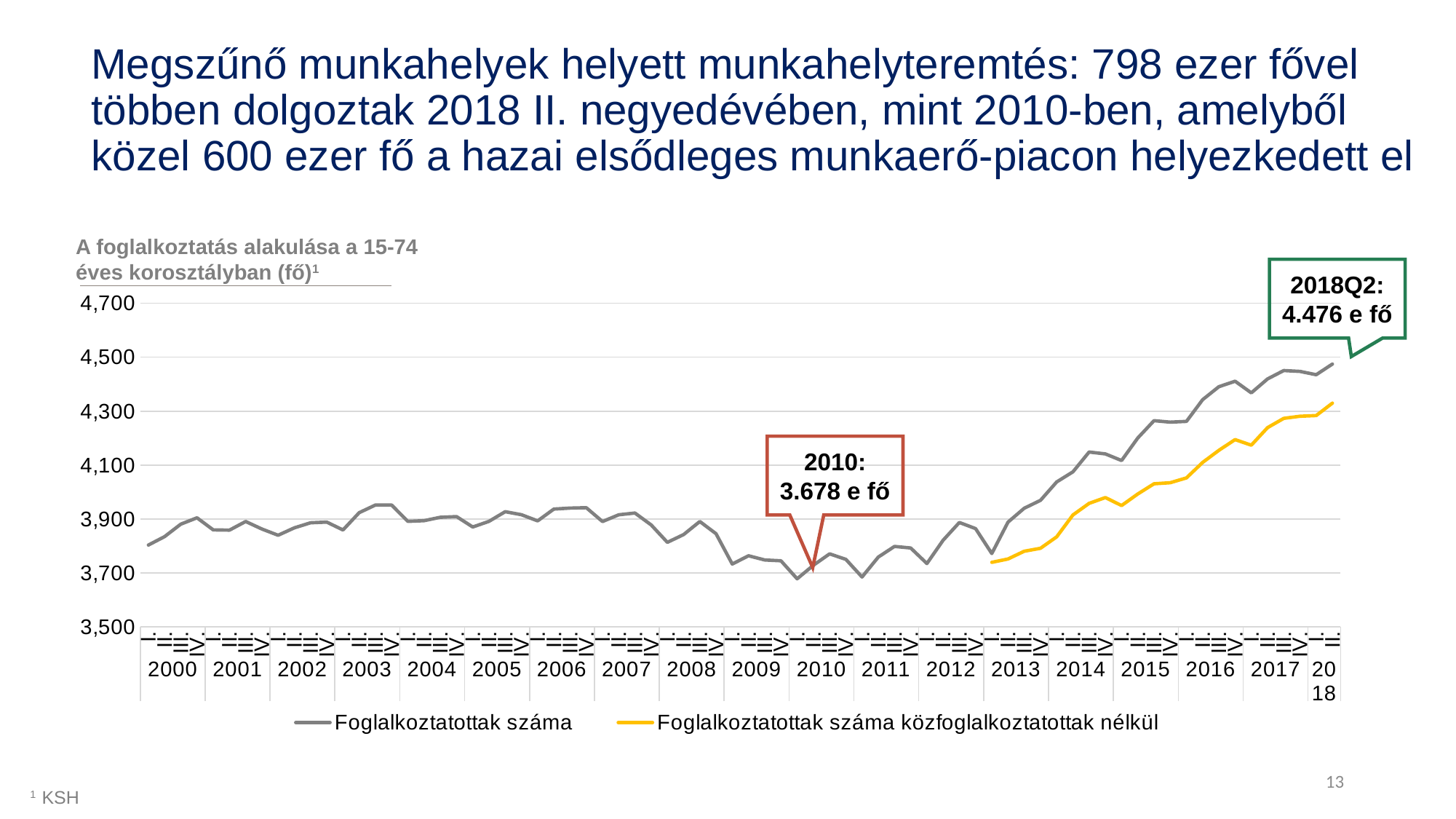
How many series does the legend list? 2 In which year does the Foglalkoztatottak száma series reach its highest point? 2018 Does the Foglalkoztatottak száma series rise or fall between 2013 and 2018? Rise In which year does the Foglalkoztatottak száma series reach its lowest point? 2010 What colour is the line for Foglalkoztatottak száma közfoglalkoztatottak nélkül? Yellow What value does the callout give for Foglalkoztatottak száma in 2018Q2? 4.476 e fő Is the value for Foglalkoztatottak száma at the start of 2000 greater or less than 3,900? less What value does the callout give for Foglalkoztatottak száma at its 2010 low point? 3.678 e fő In 2018, which series is higher: Foglalkoztatottak száma or Foglalkoztatottak száma közfoglalkoztatottak nélkül? Foglalkoztatottak száma How many years are labelled on the x axis? 19 Is the value for Foglalkoztatottak száma közfoglalkoztatottak nélkül at its first point in 2013 greater or less than 3,900? less What kind of chart is shown on the slide? Line chart